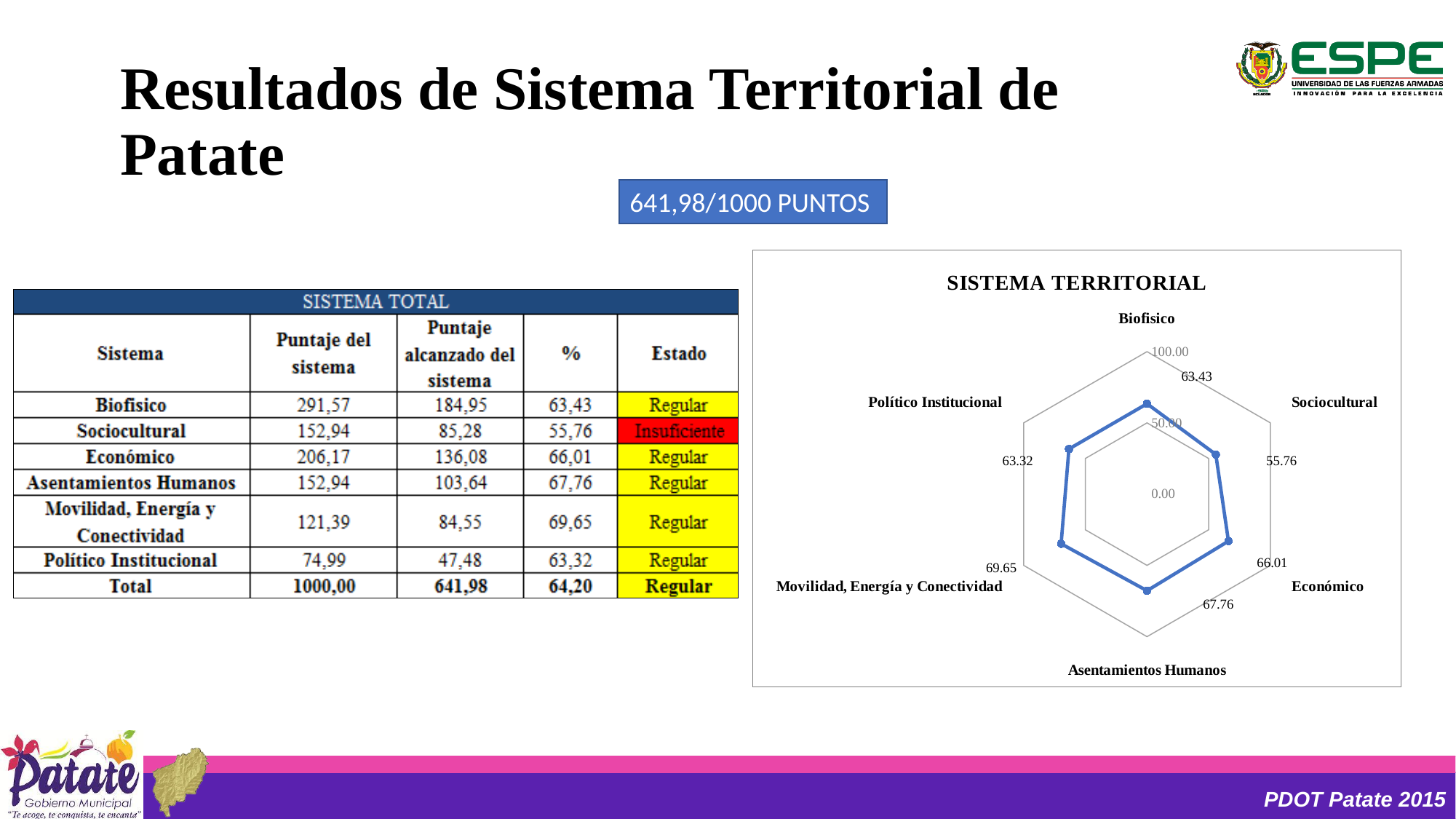
In the SISTEMA TERRITORIAL chart, what is the value for Movilidad, Energía y Conectividad? 69.65 What is the maximum value shown on the axis scale of the SISTEMA TERRITORIAL chart? 100.00 What type of chart is shown under the title SISTEMA TERRITORIAL? Radar chart In the SISTEMA TERRITORIAL chart, which category has the lowest value? Sociocultural In the SISTEMA TERRITORIAL chart, what is the difference between the values for Asentamientos Humanos and Económico? 1.75 In the SISTEMA TERRITORIAL chart, what is the value for Sociocultural? 55.76 In the SISTEMA TERRITORIAL chart, which is larger, the value for Económico or the value for Sociocultural? Económico In the SISTEMA TERRITORIAL chart, which category has the highest value? Movilidad, Energía y Conectividad In the SISTEMA TERRITORIAL chart, what is the value for Biofisico? 63.43 How many categories (axes) does the SISTEMA TERRITORIAL radar chart have? 6 In the SISTEMA TERRITORIAL chart, what is the value for Político Institucional? 63.32 In the SISTEMA TERRITORIAL chart, is the value for Asentamientos Humanos greater or less than 50.00? greater